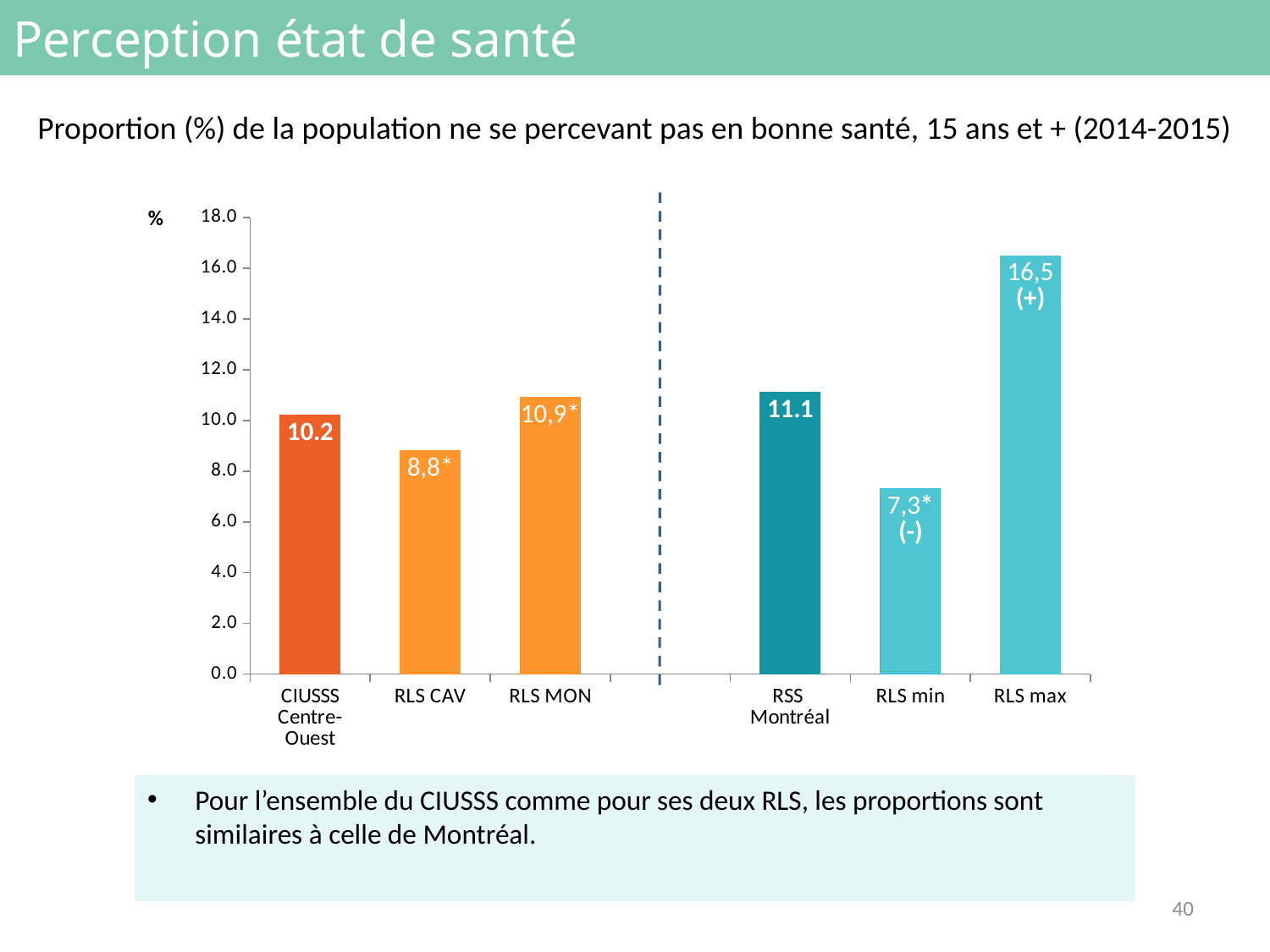
Which category has the lowest value? RLS min Is the value for RLS max greater or less than 16.0? greater What unit label is shown at the top of the y axis? % What is the value for CIUSSS Centre-Ouest? 10.2 How many categories are shown on the x axis? 6 What is the difference between the values for RSS Montréal and CIUSSS Centre-Ouest? 0.9 What is the value for RSS Montréal? 11.1 Which is larger, the value for RLS MON or the value for RLS CAV? RLS MON What is the value for RLS CAV? 8,8 What kind of chart is shown on the slide? bar chart Which category has the highest value? RLS max What is the value for RLS max? 16,5